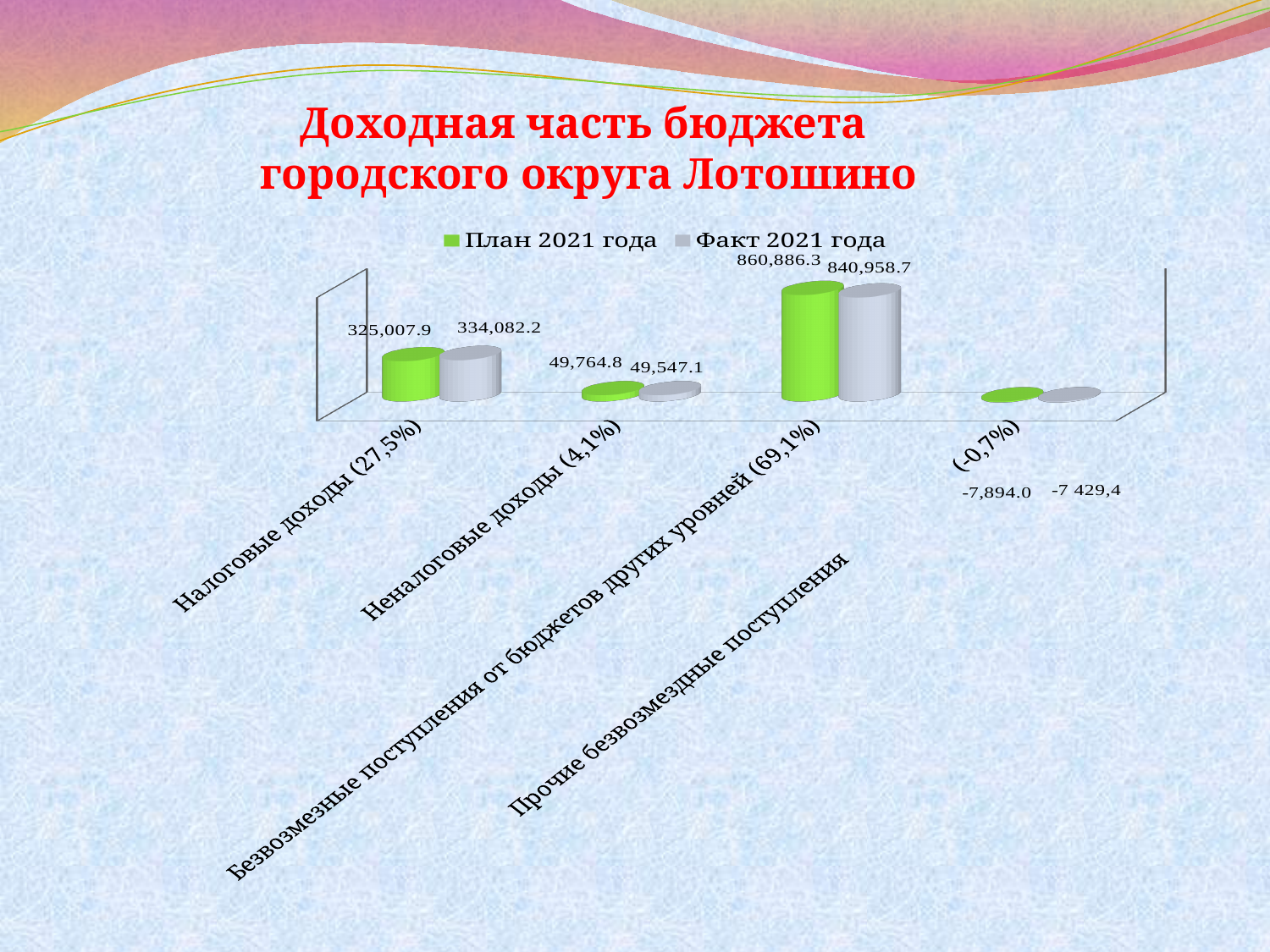
What is the difference between the План 2021 года and Факт 2021 года values for Безвозмездные поступления от бюджетов других уровней? 19,927.6 Which category has the lowest План 2021 года value? Прочие безвозмездные поступления For Безвозмездные поступления от бюджетов других уровней, which is larger: План 2021 года or Факт 2021 года? План 2021 года What is the Факт 2021 года value for Налоговые доходы? 334,082.2 How many series does the legend list? 2 What is the План 2021 года value for Прочие безвозмездные поступления? -7,894.0 Which category has the highest Факт 2021 года value? Безвозмездные поступления от бюджетов других уровней What is the difference between the Факт 2021 года and План 2021 года values for Налоговые доходы? 9,074.3 What is the План 2021 года value for Налоговые доходы? 325,007.9 What is the Факт 2021 года value for Неналоговые доходы? 49,547.1 What type of chart is shown on the slide? Bar chart What is the План 2021 года value for Безвозмездные поступления от бюджетов других уровней? 860,886.3